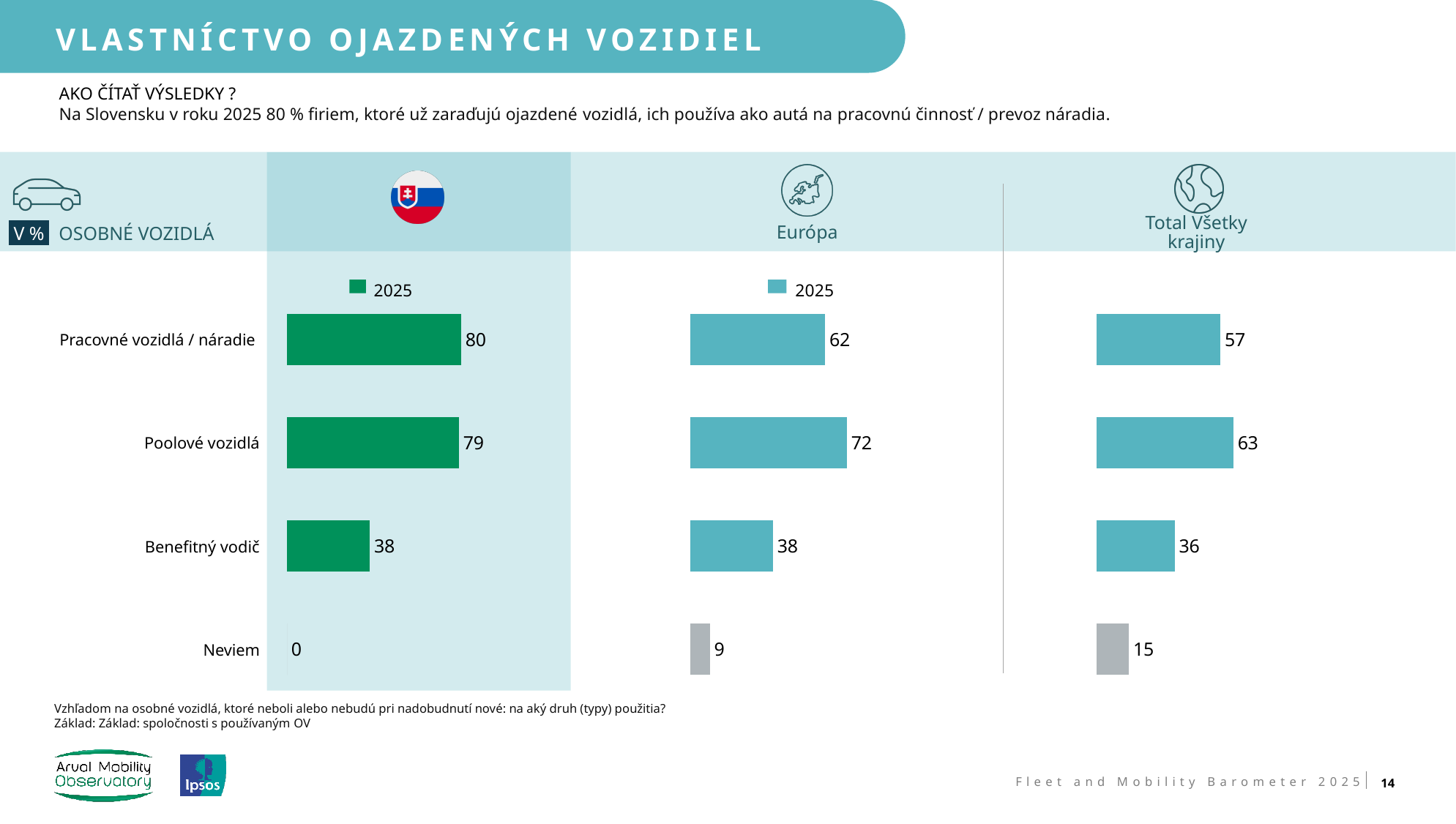
In the Európa chart (middle), which category has the highest value? Poolové vozidlá In the Total Všetky krajiny chart (right), what is the difference between Poolové vozidlá and Benefitný vodič? 27 In the Slovakia chart (left, with the flag), which category has the lowest value? Neviem In the Európa chart (middle), what is the value for Poolové vozidlá? 72 In the Total Všetky krajiny chart (right), what is the value for Neviem? 15 In the Total Všetky krajiny chart (right), what is the value for Benefitný vodič? 36 In the Európa chart (middle), what is the difference between Poolové vozidlá and Pracovné vozidlá / náradie? 10 How many categories are shown in the Slovakia chart (left, with the flag)? 4 Which is larger: the value for Pracovné vozidlá / náradie in the Slovakia chart (left) or in the Európa chart (middle)? Slovakia chart (80) What kind of chart is used in the Európa section (middle)? Bar chart In the Slovakia chart (left, with the flag), what is the value for Pracovné vozidlá / náradie? 80 Which year does the legend above the Slovakia chart (left) show? 2025